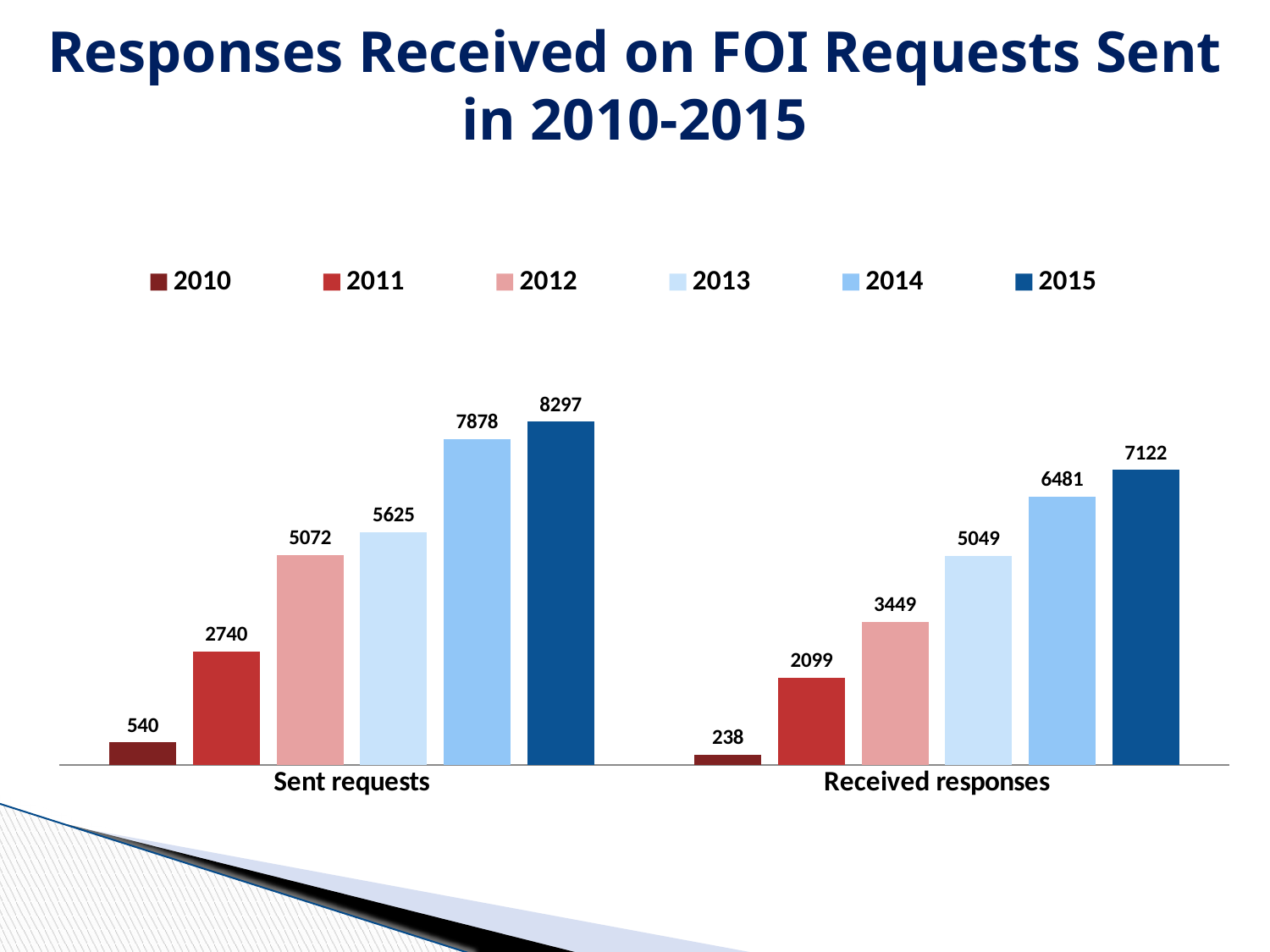
What is the difference between sent requests in 2014 and 2013? 2253 How many sent requests were there in 2013? 5625 How many received responses were there in 2011? 2099 Do the received responses rise or fall from 2010 to 2015? Rise What is the difference between sent requests and received responses in 2015? 1175 Which is larger: sent requests in 2012 or received responses in 2014? Received responses in 2014 How many categories are shown on the x axis? 2 What is the title of the chart? Responses Received on FOI Requests Sent in 2010-2015 Which year had the highest number of sent requests? 2015 What kind of chart is shown on the slide? Bar chart Which year had the lowest number of received responses? 2010 How many series does the legend list? 6